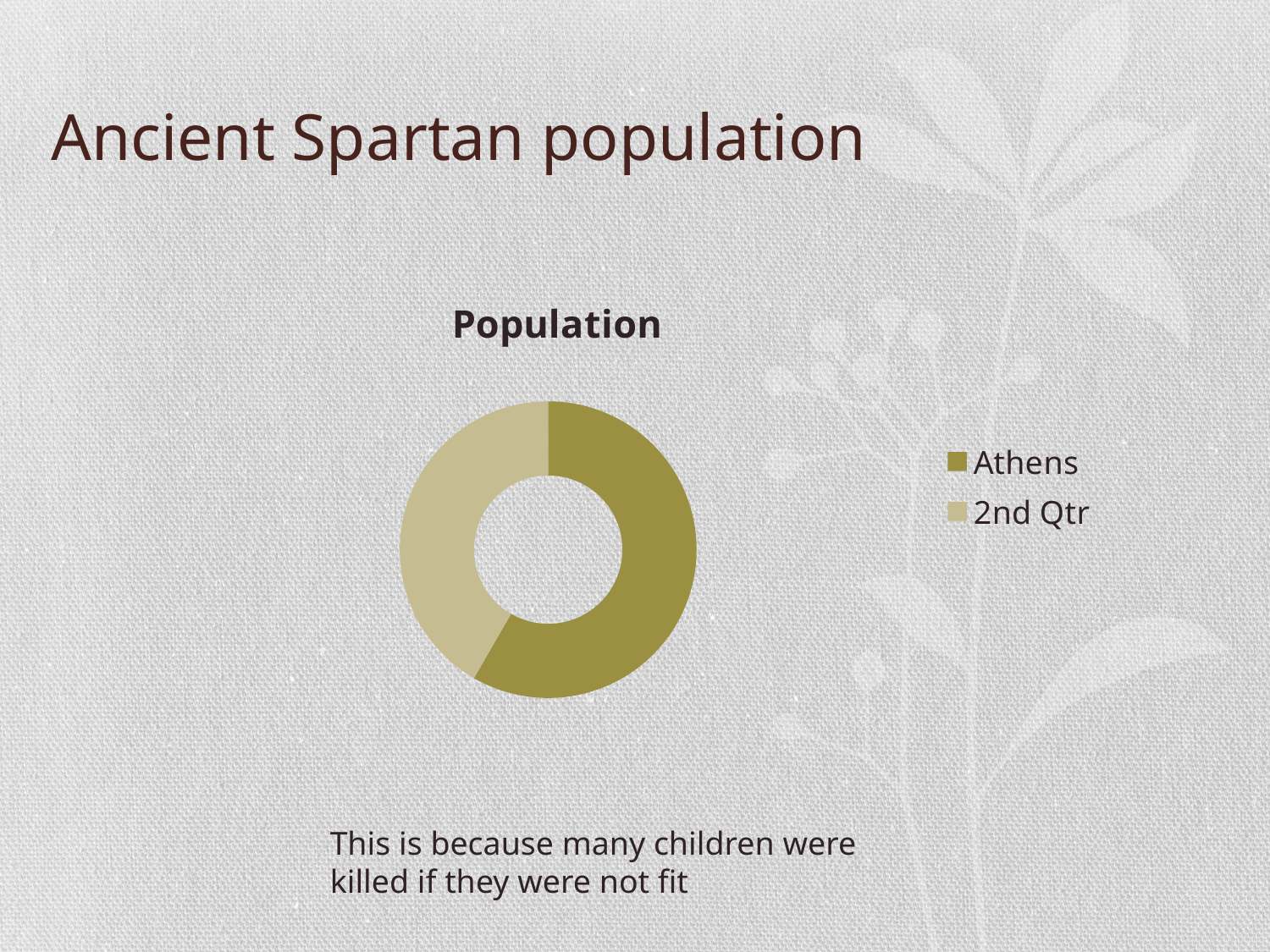
Which legend entry is shown in the lighter colour? 2nd Qtr Which category has the largest slice in the chart? Athens Which slice is larger, Athens or 2nd Qtr? Athens How many entries does the chart legend list? 2 What kind of chart is shown on the slide? Doughnut chart Which category has the smallest slice in the chart? 2nd Qtr What is the title of the chart? Population How many slices does the doughnut chart have? 2